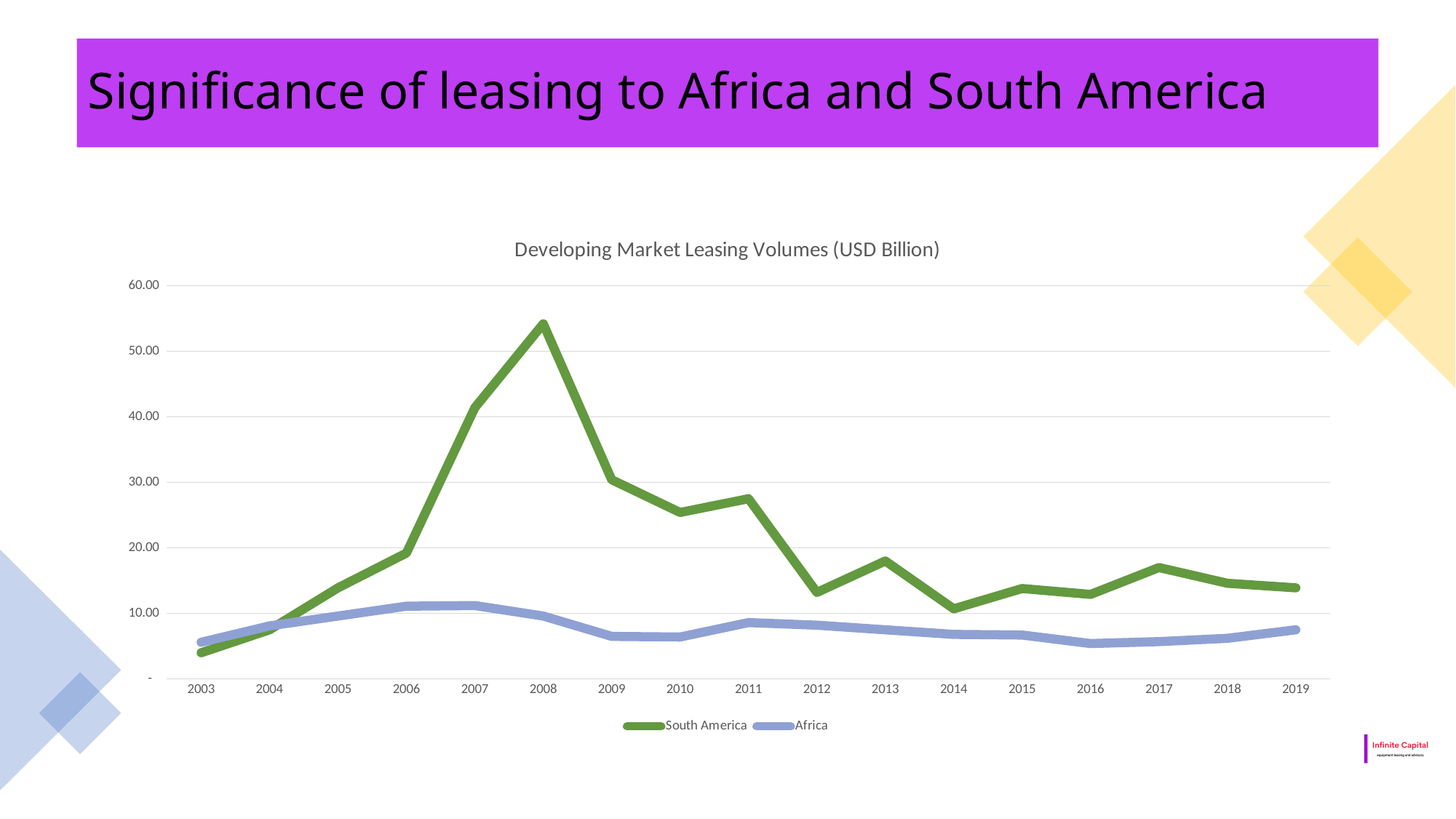
How many series does the legend list? 2 Is the value for Africa in 2019 greater or less than 10.00? less Which series has the larger value in 2003, South America or Africa? Africa Which series are listed in the legend? South America and Africa In which year is the South America series at its lowest value? 2003 Does the South America series rise or fall between 2008 and 2012? fall Is the value for South America in 2008 greater or less than 50.00? greater Which series has the larger value in 2010, South America or Africa? South America In which year does the South America series reach its highest value? 2008 What is the title of the chart? Developing Market Leasing Volumes (USD Billion) How many years are shown on the x axis? 17 What kind of chart is shown on the slide? line chart